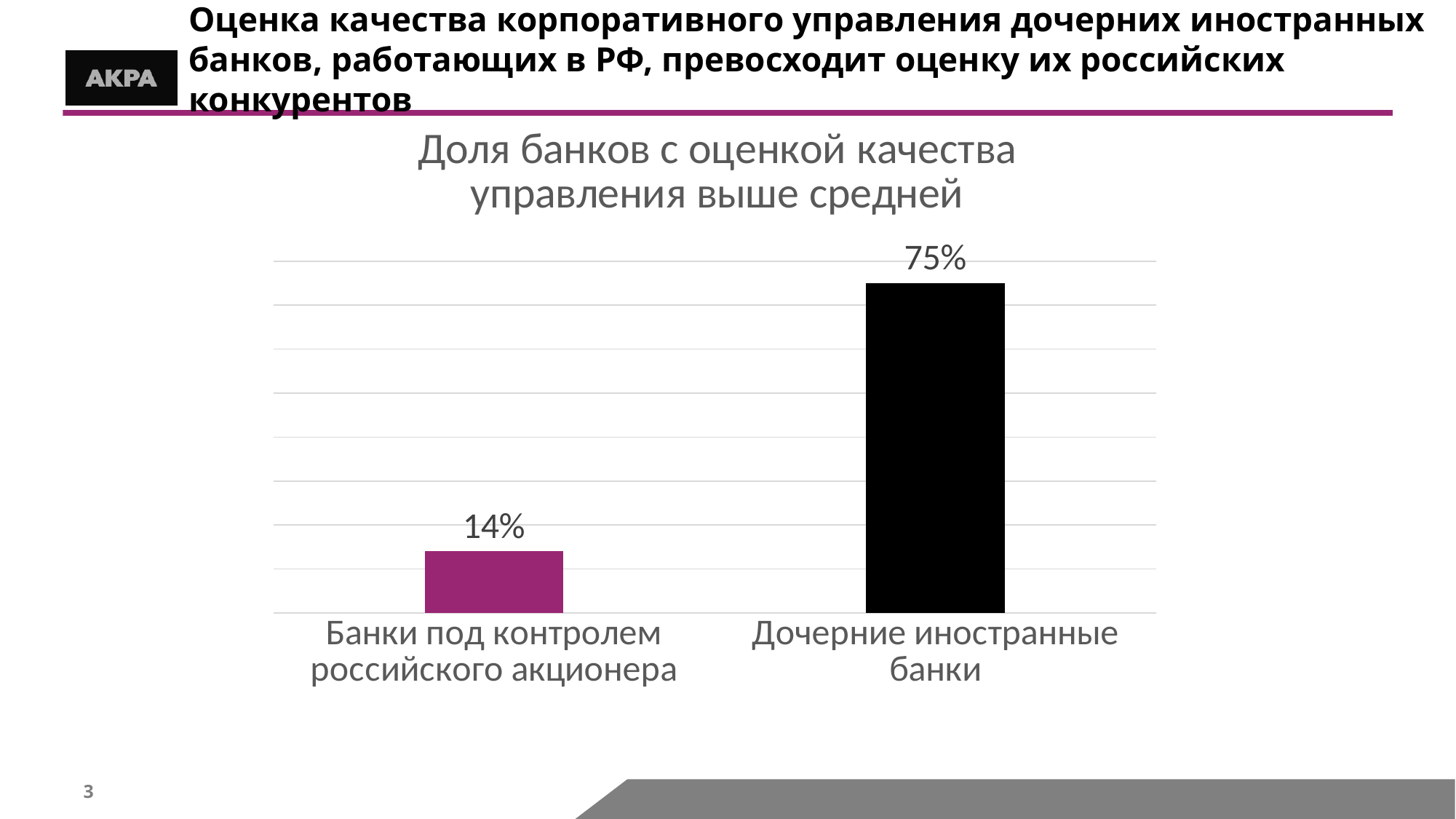
Which category has the lowest value? Банки под контролем российского акционера Which category has the highest value? Дочерние иностранные банки What is the value for Банки под контролем российского акционера? 14% What is the difference between the values for Дочерние иностранные банки and Банки под контролем российского акционера? 61% What kind of chart is shown on the slide? Bar chart What is the title of the chart? Доля банков с оценкой качества управления выше средней What is the value for Дочерние иностранные банки? 75% How many categories are shown in the chart? 2 Which is larger: the value for Банки под контролем российского акционера or the value for Дочерние иностранные банки? Дочерние иностранные банки What colour is the bar for Дочерние иностранные банки? Black